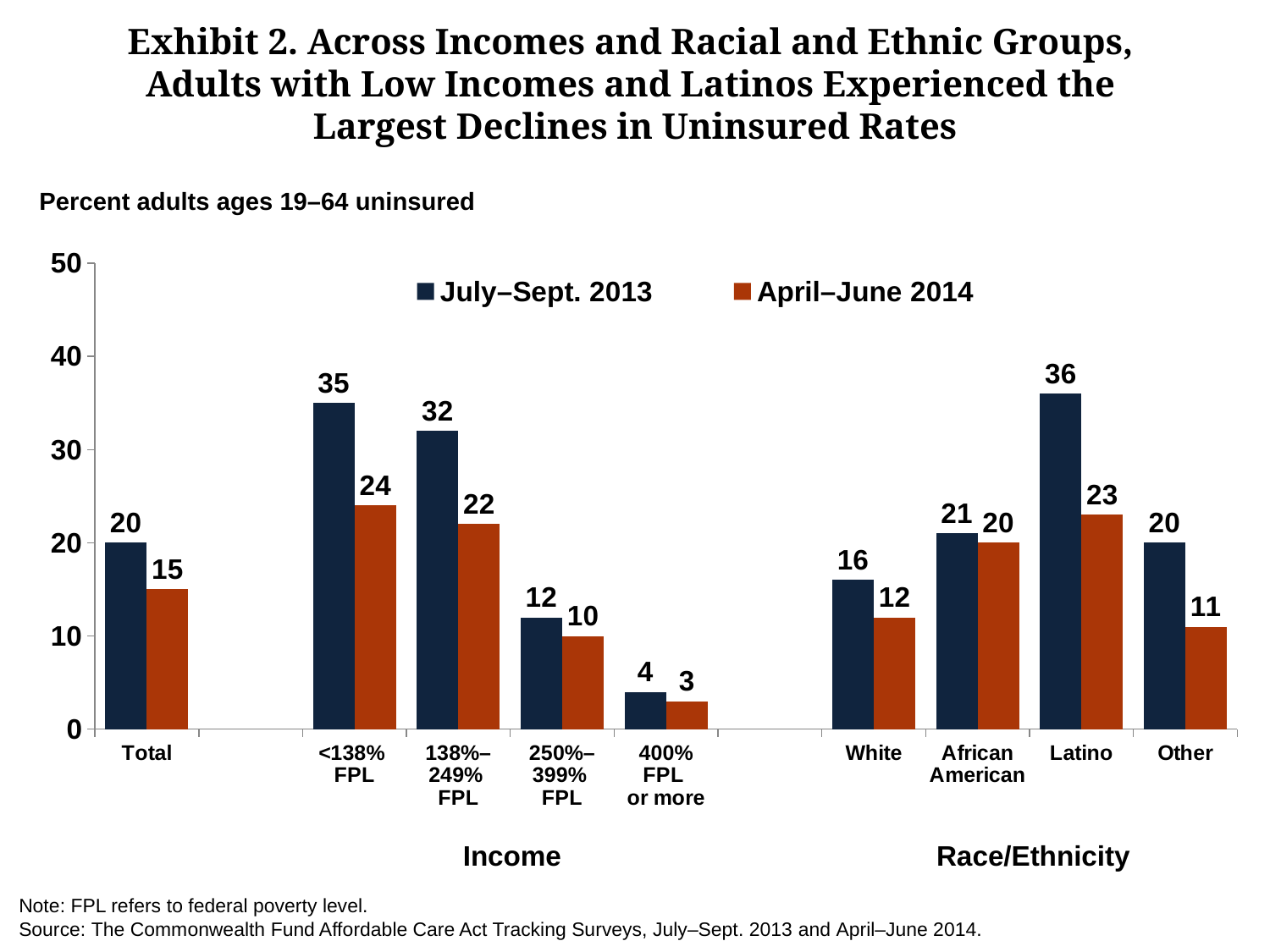
Which is larger, the April–June 2014 value for White or the April–June 2014 value for Other? White What is the difference between the July–Sept. 2013 and April–June 2014 values for <138% FPL? 11 What is the July–Sept. 2013 value for Latino? 36 What is the April–June 2014 value for <138% FPL? 24 Which series is shown in dark blue? July–Sept. 2013 What kind of chart is shown on the slide? Bar chart Which category has the lowest April–June 2014 value? 400% FPL or more What is the April–June 2014 value for Total? 15 How many categories are shown on the x axis? 9 Which category has the highest July–Sept. 2013 value? Latino What is the difference between the July–Sept. 2013 and April–June 2014 values for Latino? 13 How many series does the legend list? 2